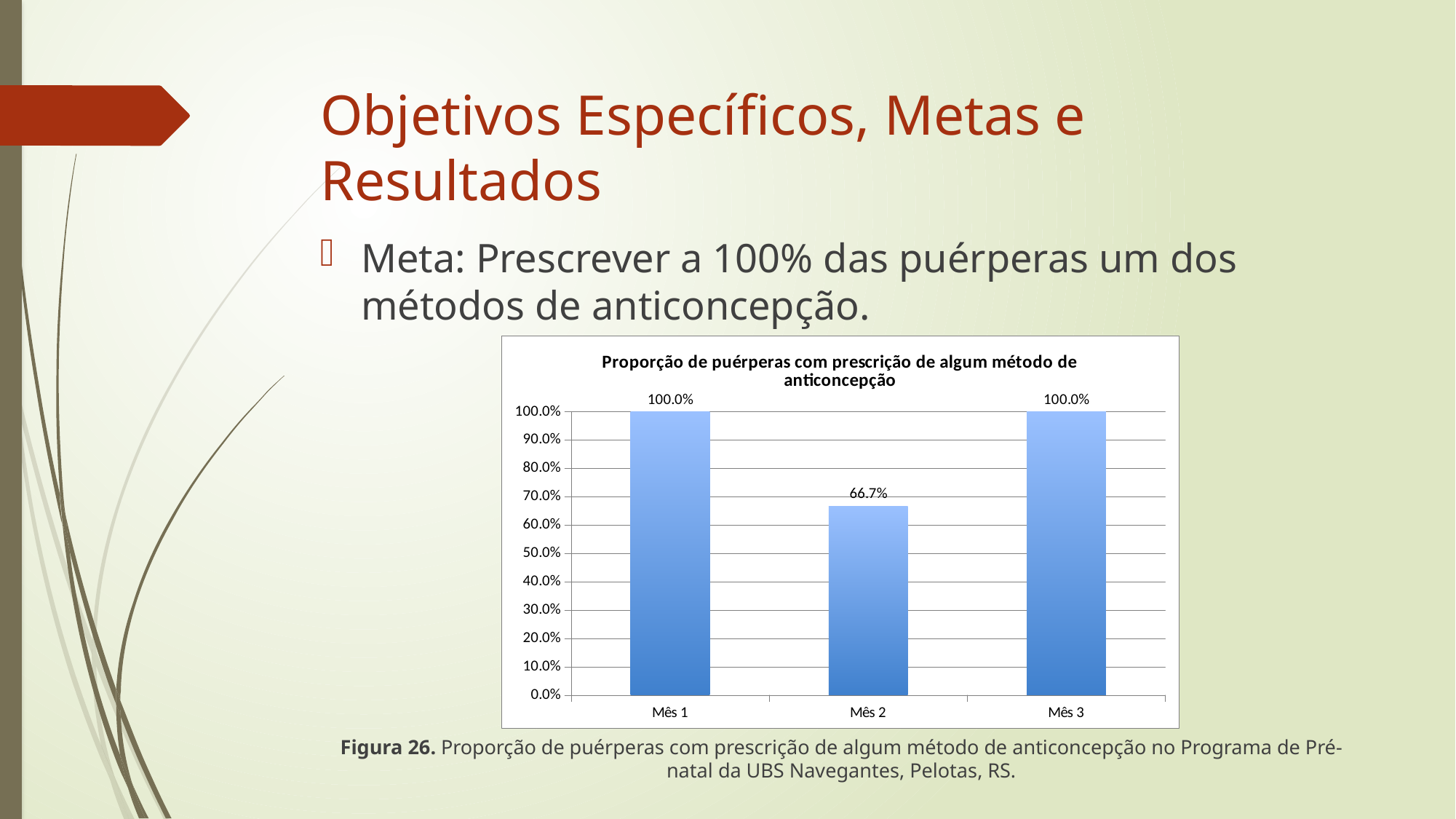
What is the value for Mês 2? 66.7% Which month has the lowest value? Mês 2 How many months are shown on the x axis? 3 What is the highest value shown on the y axis? 100.0% Which is larger, the value for Mês 2 or the value for Mês 3? Mês 3 What is the value for Mês 1? 100.0% What kind of chart is shown on the slide? bar chart What is the difference between the values for Mês 1 and Mês 2? 33.3% Is the value for Mês 2 greater or less than 70.0%? less What is the title of the chart? Proporção de puérperas com prescrição de algum método de anticoncepção What is the value for Mês 3? 100.0% Does the value rise or fall from Mês 2 to Mês 3? rise